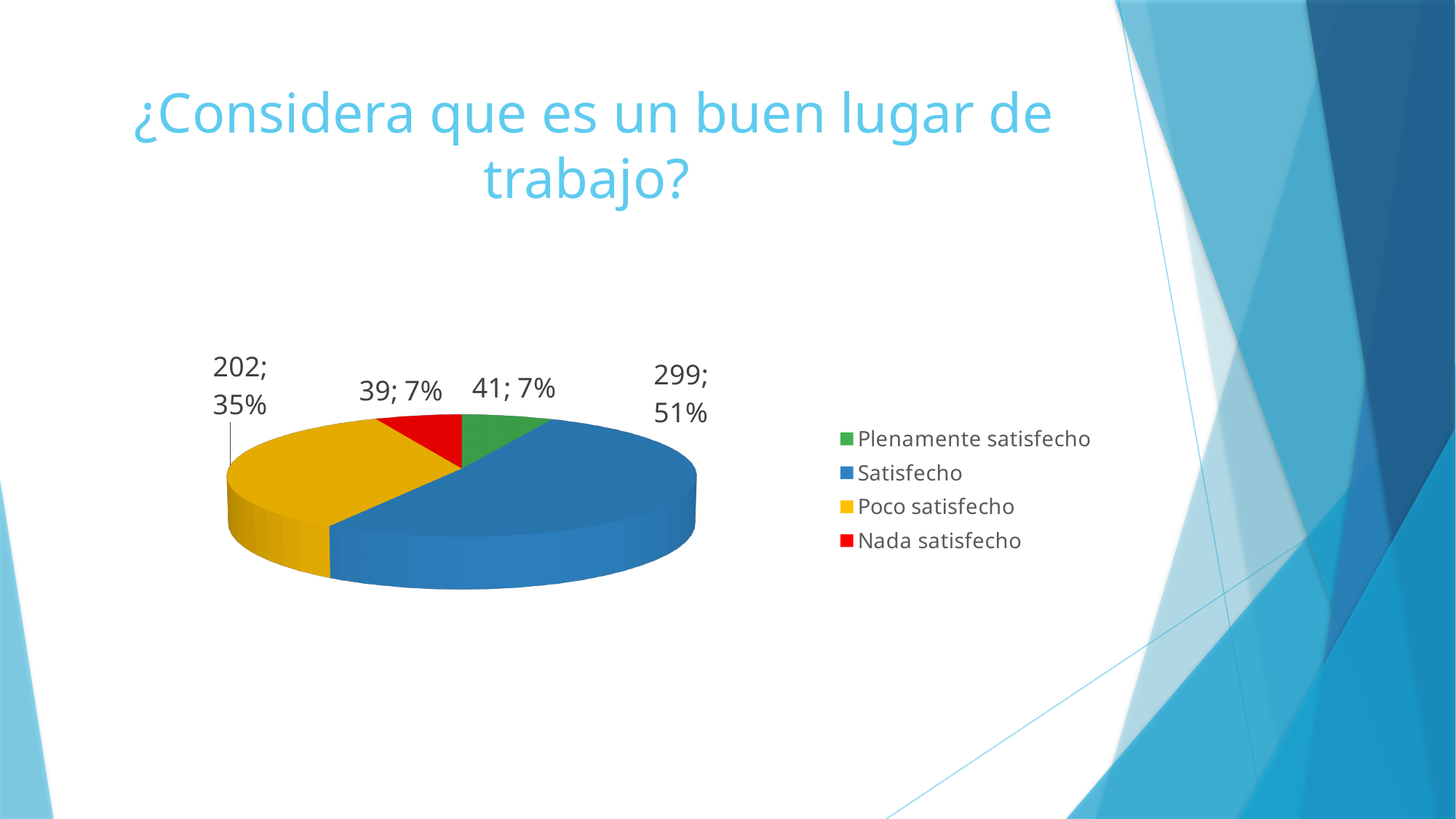
What is the count for Plenamente satisfecho? 41 What is the count for Nada satisfecho? 39 What is the difference between the counts for Satisfecho and Poco satisfecho? 97 Which category has the largest slice? Satisfecho Which is larger, the count for Plenamente satisfecho or the count for Nada satisfecho? Plenamente satisfecho What percentage of the pie does Poco satisfecho represent? 35% Which category has the smallest count? Nada satisfecho What kind of chart is shown on the slide? pie chart What is the count for Satisfecho? 299 How many slices does the pie chart have? 4 What percentage of the pie does Satisfecho represent? 51% What colour is the Poco satisfecho slice? yellow